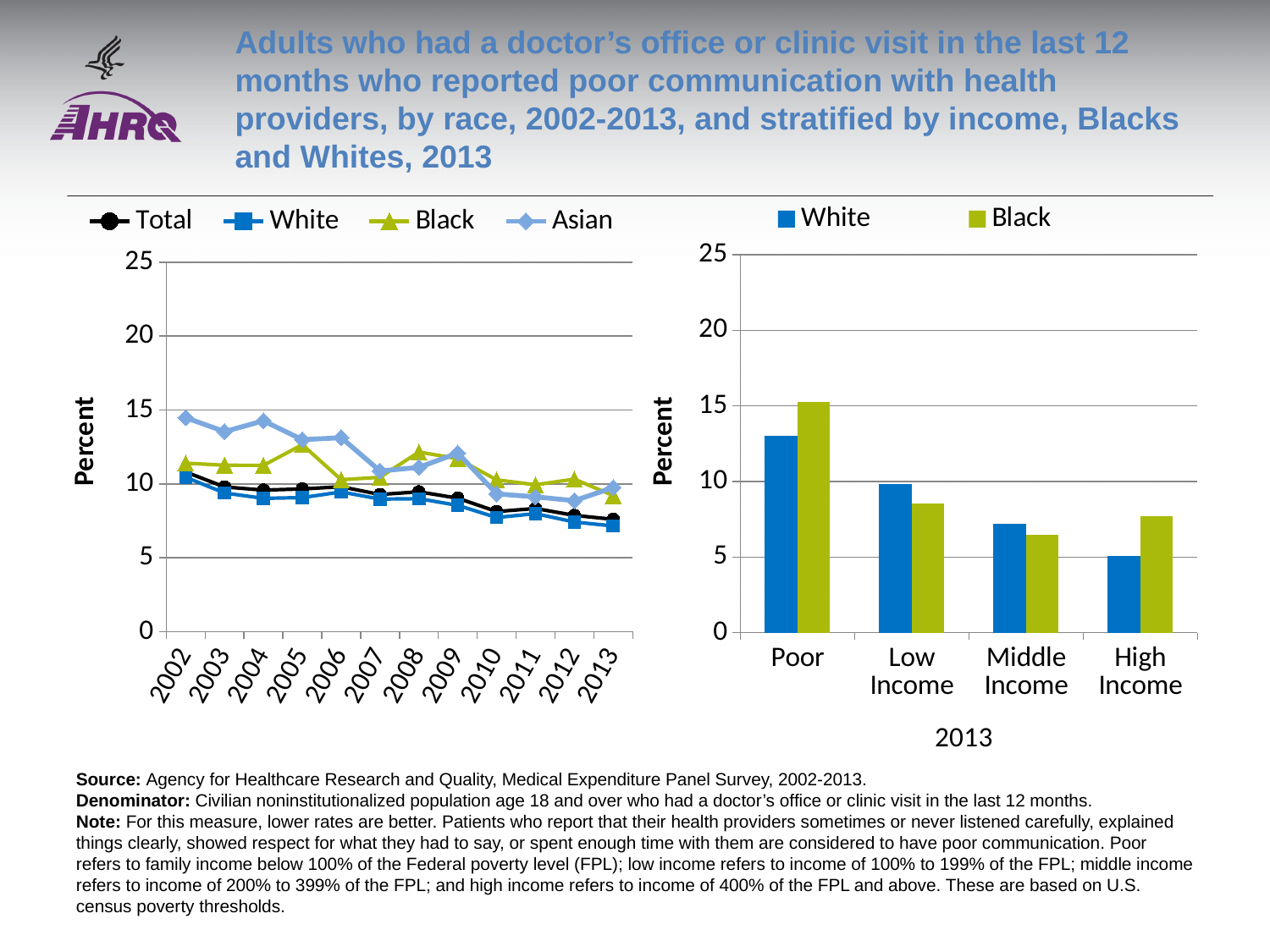
In the left chart, which group had the lowest rate in 2013? White In the left chart, does the Total rate rise or fall from 2002 to 2013? fall In the right chart, which bar is the highest? Black, Poor What kind of chart is the left chart showing rates by race from 2002 to 2013? line chart In the left chart, is the value for Asian in 2002 greater or less than 10? greater In the left chart, how many years are shown on the x axis? 12 In the left chart, is the value for White in 2013 greater or less than 10? less In the right chart, how many income categories are shown on the x axis? 4 What kind of chart is the right chart showing rates by income for 2013? bar chart In the right chart, for the Low Income group, which is larger, White or Black? White In the left chart, how many series does the legend list? 4 In the left chart, which group had the highest rate in 2002? Asian